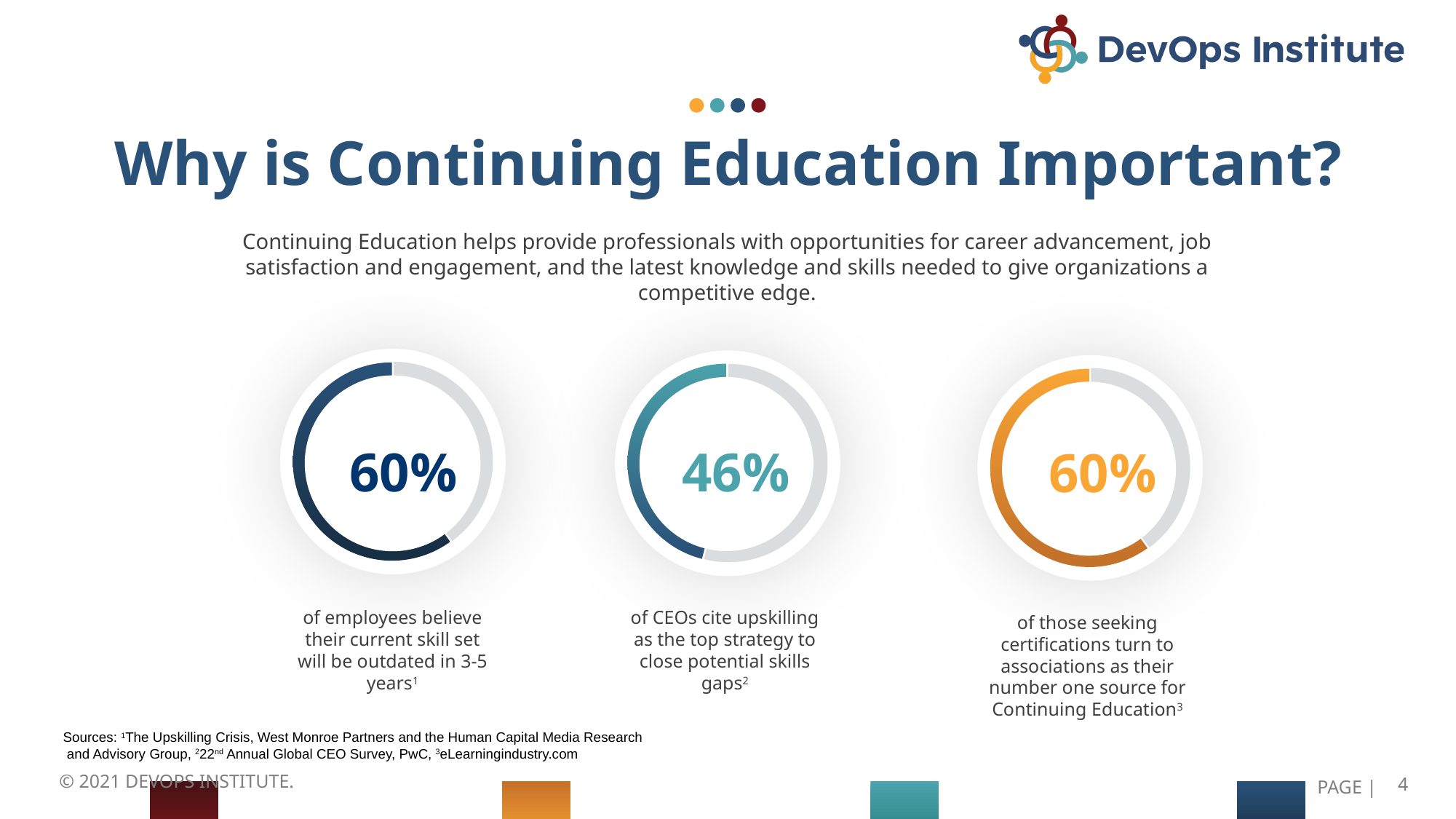
What kind of chart is used to display the three statistics on the slide? Ring (donut) charts Which of the three ring charts shows the lowest percentage? The middle chart (CEOs citing upskilling), 46% What percentage is shown in the right ring chart about those seeking certifications who turn to associations as their number one source for Continuing Education? 60% What colour is the filled portion of the right ring chart? Orange What percentage is shown in the left ring chart about employees who believe their current skill set will be outdated in 3-5 years? 60% Do the left and right ring charts show the same percentage? Yes, both show 60% What percentage is shown in the middle ring chart about CEOs who cite upskilling as the top strategy to close potential skills gaps? 46% How many ring charts are shown on the slide? 3 Is the percentage in the left ring chart (employees) larger or smaller than the percentage in the middle ring chart (CEOs)? Larger What colour is the filled portion of the middle ring chart? Teal Is the value in the middle ring chart greater or less than 50%? less What is the difference in percentage points between the left ring chart (60%) and the middle ring chart (46%)? 14 percentage points